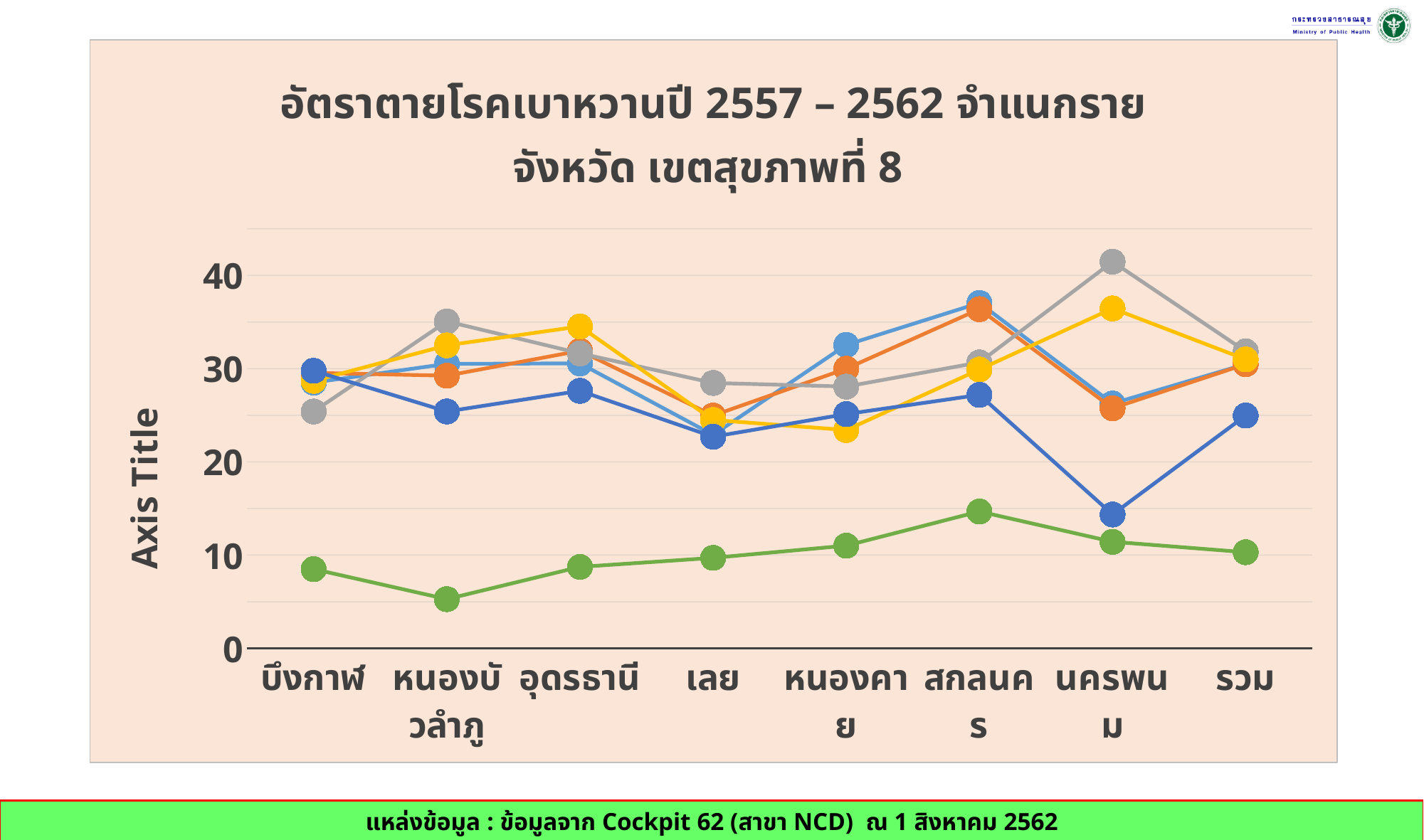
Is the value of the dark blue line for นครพนม greater or less than 20? less What kind of chart is shown on the slide? line chart What is the title of the chart? อัตราตายโรคเบาหวานปี 2557 – 2562 จำแนกรายจังหวัด เขตสุขภาพที่ 8 What is the label on the vertical axis of the chart? Axis Title For which category does the green line reach its lowest value? หนองบัวลำภู Which is larger for the green line: the value for สกลนคร or the value for บึงกาฬ? สกลนคร Is the value of the yellow line for นครพนม greater or less than 30? greater Is the value of the green line for หนองบัวลำภู greater or less than 10? less For which category does the green line reach its highest value? สกลนคร How many categories are shown along the x axis of the chart? 8